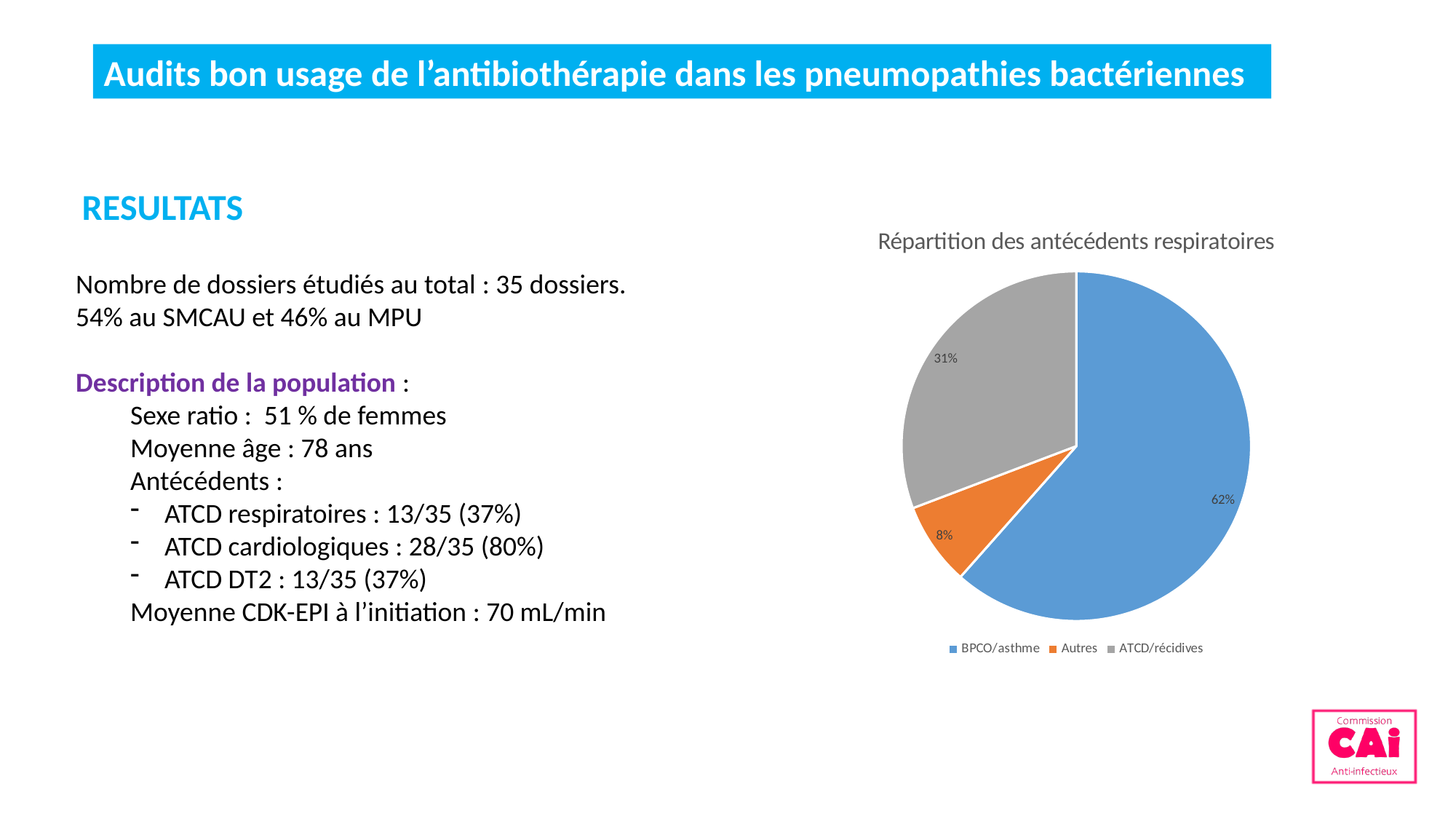
How many categories does the pie chart show? 3 Which category has the largest slice of the pie? BPCO/asthme Is the share for BPCO/asthme greater or less than 50%? greater What share of the pie does BPCO/asthme represent? 62% What is the difference in percentage points between the BPCO/asthme slice and the ATCD/récidives slice? 31 What kind of chart is shown on the slide? Pie chart Which colour represents Autres in the pie chart? Orange Which category has the smallest slice of the pie? Autres What share of the pie does Autres represent? 8% Which slice is larger, Autres or ATCD/récidives? ATCD/récidives What is the title of the chart? Répartition des antécédents respiratoires What share of the pie does ATCD/récidives represent? 31%